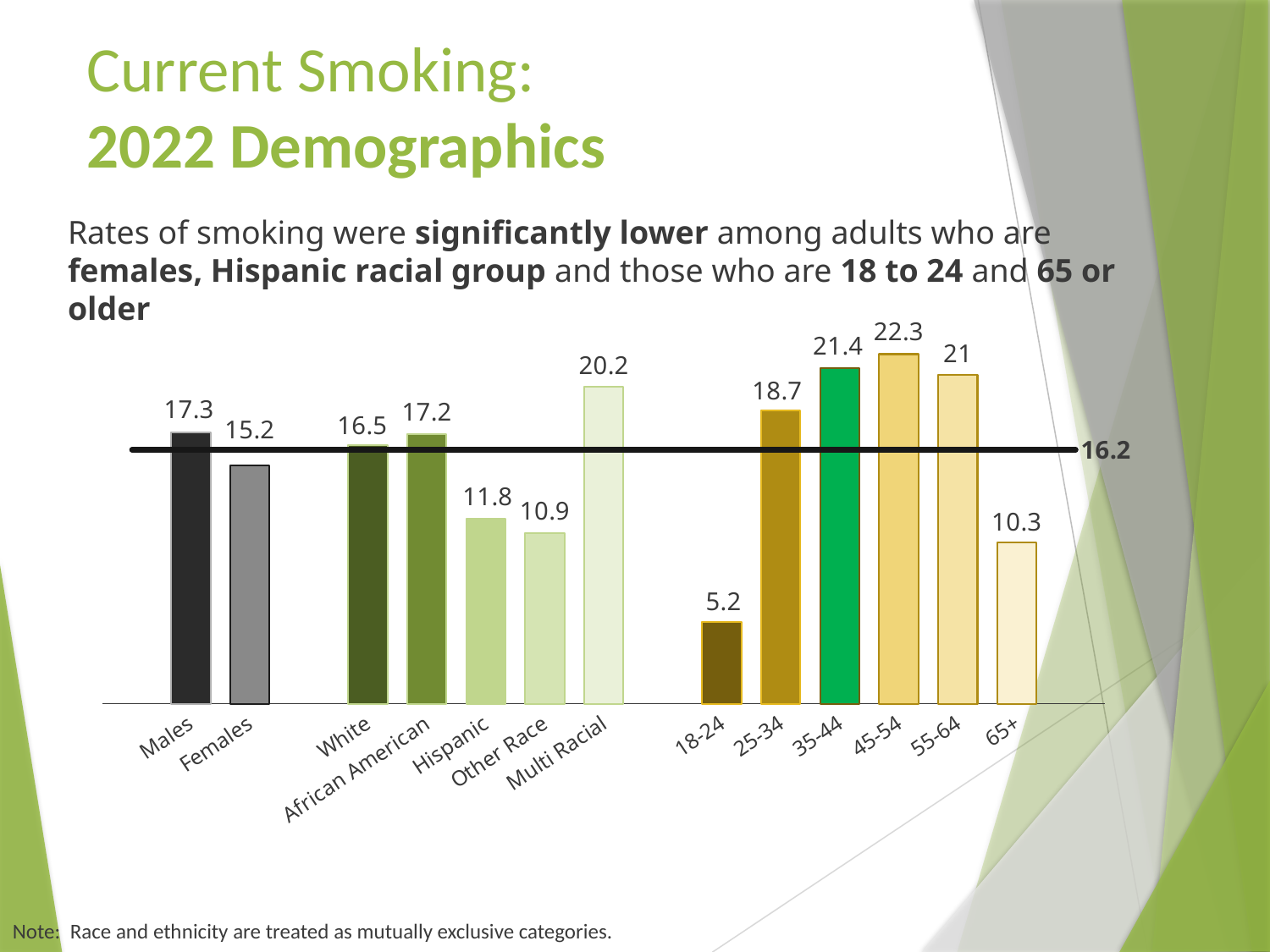
Which category has the lowest value on the chart? 18-24 Which has a higher value, Hispanic or Other Race? Hispanic Which category has the highest value on the chart? 45-54 What value is labelled on the horizontal reference line across the chart? 16.2 What kind of chart is shown on the slide? Bar chart What is the value shown for the 18-24 age group? 5.2 What is the difference between the values for Males and Females? 2.1 Which has a higher value, White or African American? African American What is the smoking rate shown for Females? 15.2 How many bars are plotted on the chart? 13 What is the difference between the values for 45-54 and 65+? 12 What is the value shown for Multi Racial? 20.2